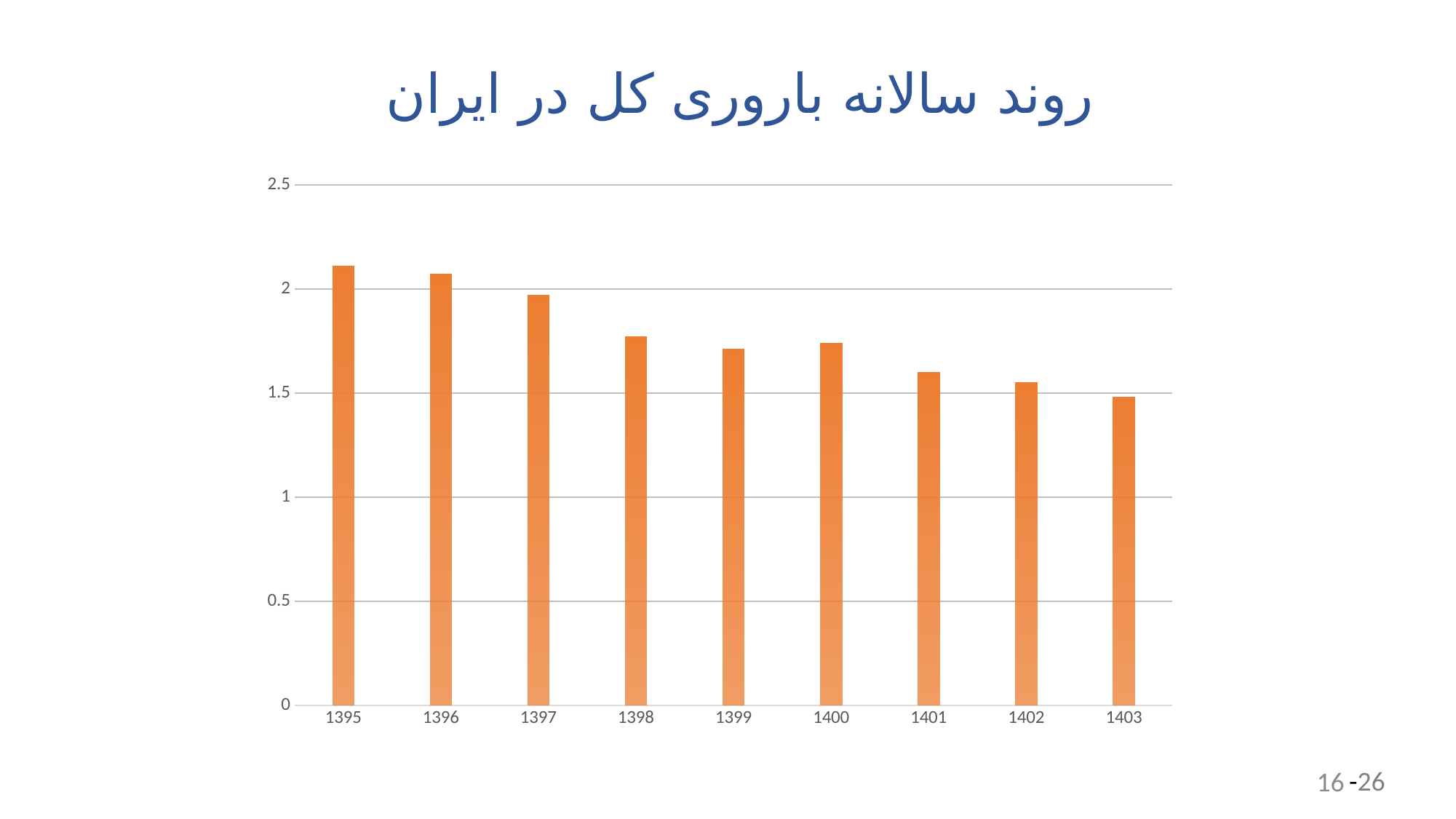
Which year has the lowest bar? 1403 Which year has the highest bar? 1395 Is the value for 1401 greater or less than 1.5? greater Is the value for 1395 greater or less than 2? greater What kind of chart is shown on the slide? Bar chart What is the title of the chart? روند سالانه باروری کل در ایران What is the highest value shown on the y axis? 2.5 Do the values generally rise or fall from 1395 to 1403? fall How many years (bars) are shown on the x axis? 9 Which is larger, the value for 1397 or the value for 1401? 1397